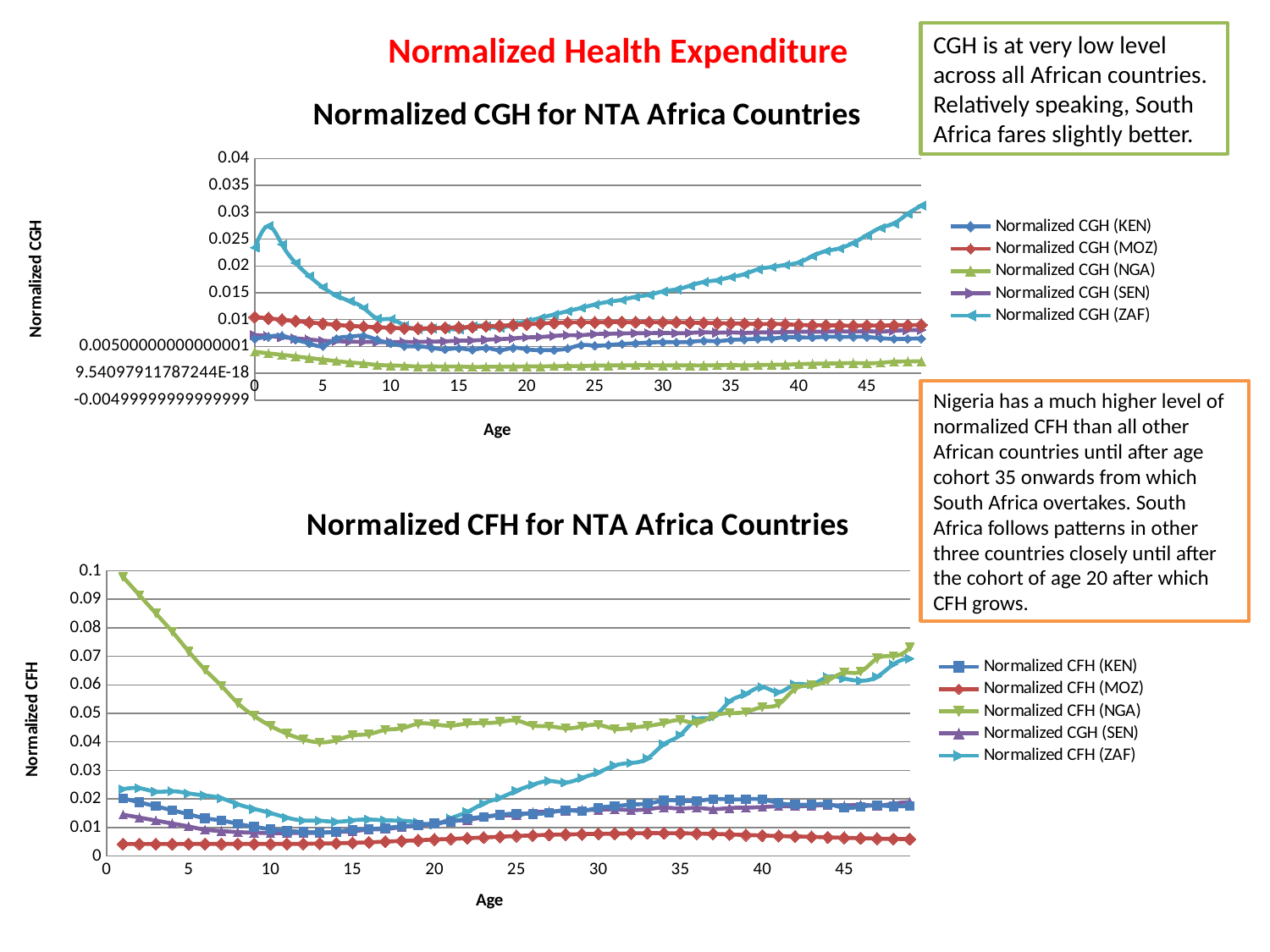
In the 'Normalized CGH for NTA Africa Countries' chart, which series has the highest value at the oldest age shown? Normalized CGH (ZAF) In the 'Normalized CFH for NTA Africa Countries' chart, which series has the highest value at the youngest age? Normalized CFH (NGA) In the 'Normalized CFH for NTA Africa Countries' chart, does the Normalized CFH (ZAF) series rise or fall from age 20 to the end of the x axis? rise How many series does the legend of the 'Normalized CGH for NTA Africa Countries' chart list? 5 In the 'Normalized CFH for NTA Africa Countries' chart, is the value for Normalized CFH (MOZ) at age 10 greater or less than 0.01? less What is the x-axis title of the 'Normalized CGH for NTA Africa Countries' chart? Age How many series does the legend of the 'Normalized CFH for NTA Africa Countries' chart list? 5 In the 'Normalized CFH for NTA Africa Countries' chart, which series stays lowest across all ages? Normalized CFH (MOZ) What kind of chart is the 'Normalized CGH for NTA Africa Countries' chart? line chart In the 'Normalized CFH for NTA Africa Countries' chart, at age 30, which is larger: Normalized CFH (NGA) or Normalized CFH (ZAF)? Normalized CFH (NGA) In the 'Normalized CFH for NTA Africa Countries' chart, is the value for Normalized CFH (NGA) at age 1 greater or less than 0.09? greater